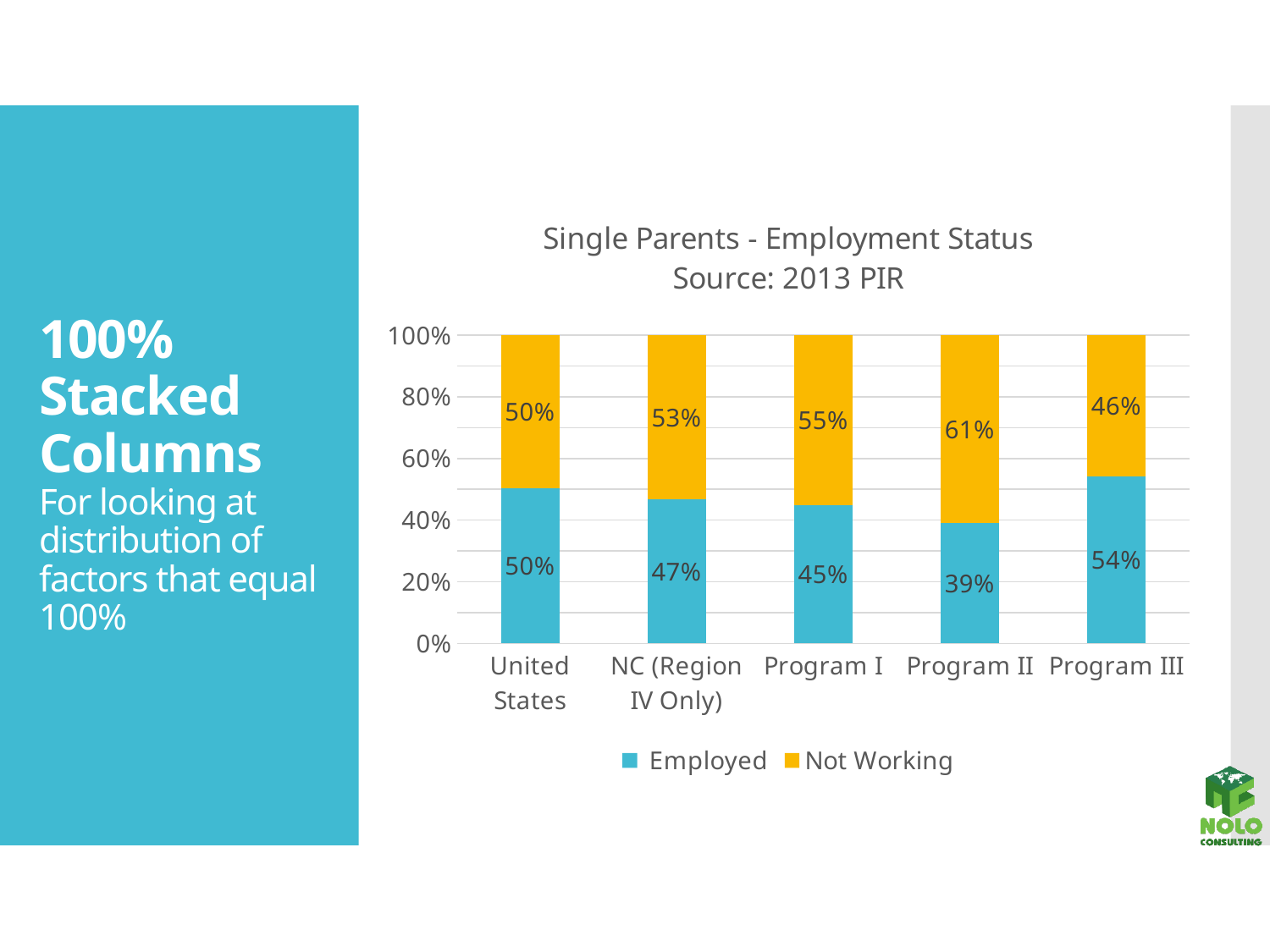
Which category has the highest Not Working value? Program II Which category has the lowest Employed value? Program II What kind of chart is shown on the slide? Stacked bar chart Which category has the highest Employed value? Program III How many series does the legend list? 2 What is the title of the chart? Single Parents - Employment Status Source: 2013 PIR How many categories are shown on the x axis? 5 What is the Not Working value for Program III? 46% What is the difference between the Not Working value for Program II and the Not Working value for United States? 11% What is the Employed value for Program II? 39% What is the Employed value for NC (Region IV Only)? 47% Is the Employed value for Program I larger or the Employed value for Program III? Program III